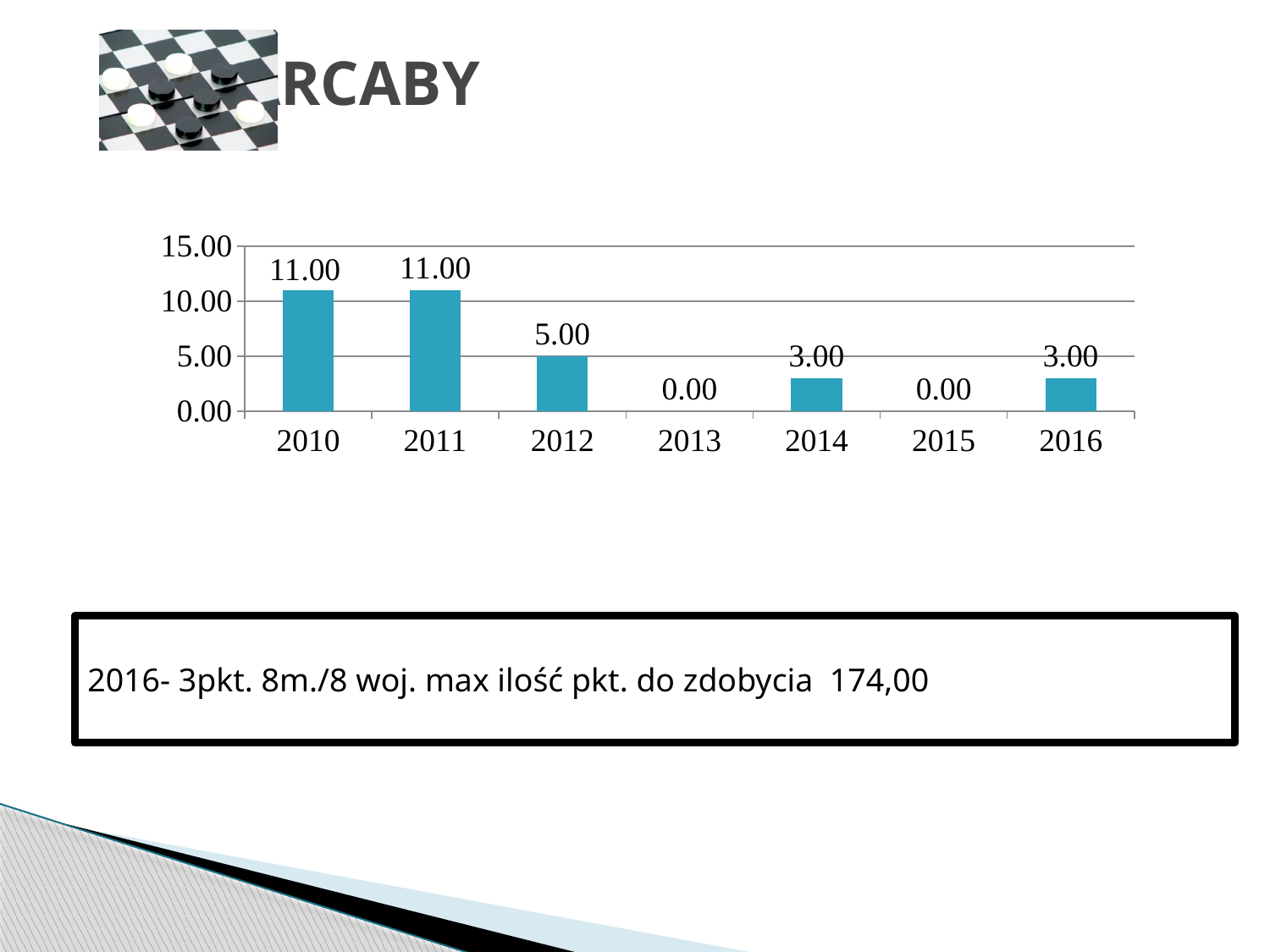
What kind of chart is shown on the slide? bar chart What is the difference between the values for 2012 and 2016? 2.00 Which is larger, the value for 2010 or the value for 2014? 2010 What is the difference between the values for 2011 and 2012? 6.00 How many years are shown on the x axis? 7 Is the value for 2011 greater or less than 10.00? greater What is the value for 2013? 0.00 What is the value for 2014? 3.00 Which years have the lowest value? 2013 and 2015 What is the value for 2012? 5.00 Which years have the highest value? 2010 and 2011 What is the value for 2016? 3.00